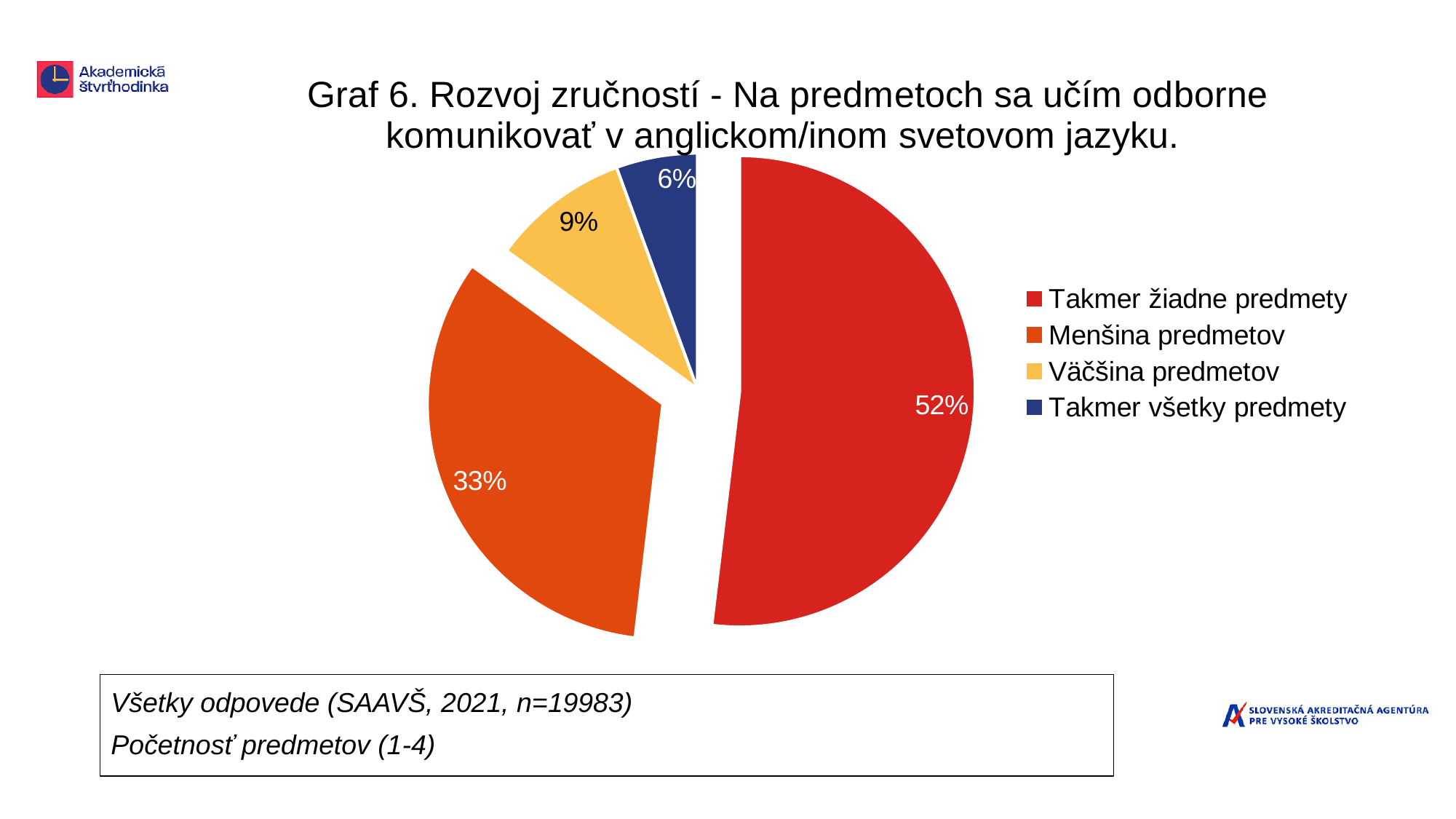
What is the value for "Menšina predmetov"? 33% What is the sample size (n) stated in the note below the chart? 19983 Which category has the largest slice of the pie? Takmer žiadne predmety What is the value for "Takmer všetky predmety"? 6% What is the value for "Väčšina predmetov"? 9% Which category has the smallest slice of the pie? Takmer všetky predmety What share of the pie does "Takmer žiadne predmety" have? 52% What kind of chart is shown on the slide? Pie chart What colour is the slice for "Menšina predmetov"? Orange How many categories does the pie chart show? 4 What is the difference in percentage points between "Takmer žiadne predmety" and "Menšina predmetov"? 19 Which is larger, "Väčšina predmetov" or "Takmer všetky predmety"? Väčšina predmetov